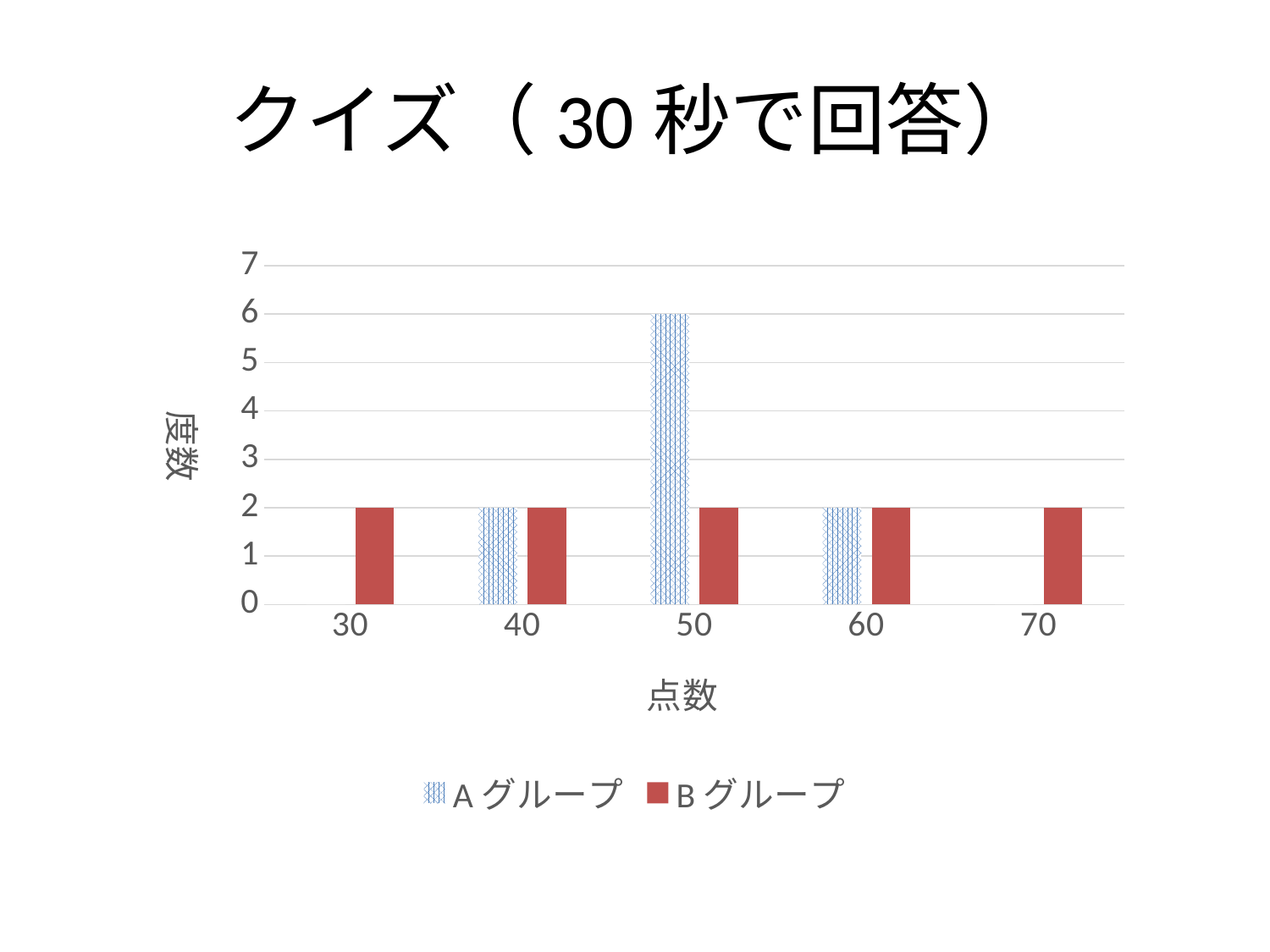
Is the value for A グループ at 点数 50 greater or less than 5? greater What is the label of the x axis? 点数 What is the difference between A グループ and B グループ at 点数 50? 4 How many series does the legend list? 2 What kind of chart is shown on the slide? bar chart At which 点数 is the value for A グループ highest? 50 What is the label of the y axis? 度数 What is the value for A グループ at 点数 40? 2 What is the value for B グループ at 点数 70? 2 What is the value for A グループ at 点数 50? 6 At 点数 50, which series has the larger value, A グループ or B グループ? A グループ How many categories are shown on the x axis? 5